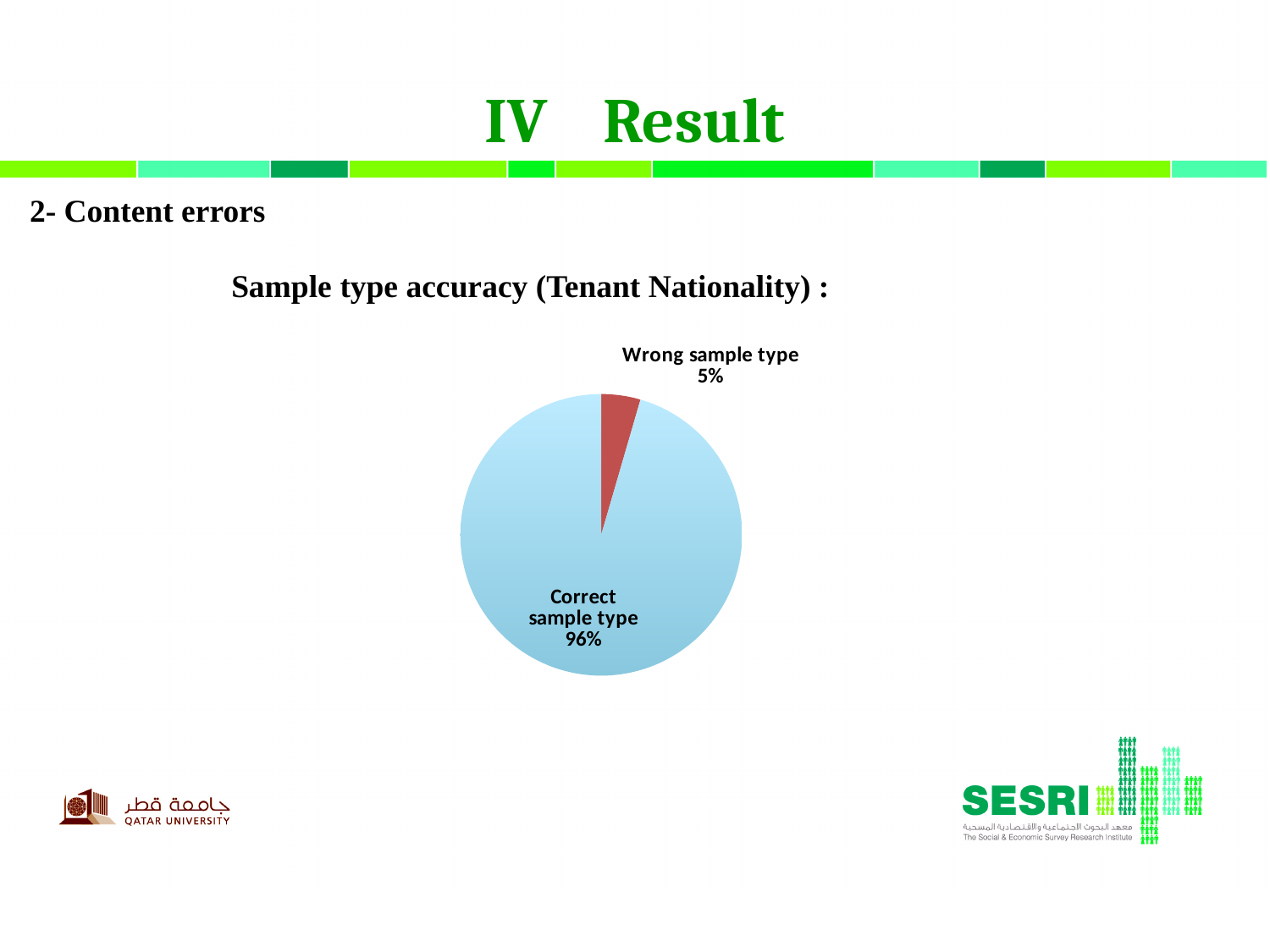
What kind of chart is shown on the slide? pie chart What percentage of the pie is labelled "Correct sample type"? 96% What share of the pie does the "Wrong sample type" slice represent? 5% Which slice of the pie is the largest? Correct sample type Which is larger, the "Correct sample type" slice or the "Wrong sample type" slice? Correct sample type Which slice of the pie is the smallest? Wrong sample type What colour is the "Wrong sample type" slice? red What is the difference in percentage points between the "Correct sample type" and "Wrong sample type" slices? 91 What is the heading above the pie chart? Sample type accuracy (Tenant Nationality) : What percentage of the pie is labelled "Wrong sample type"? 5% How many slices does the pie chart have? 2